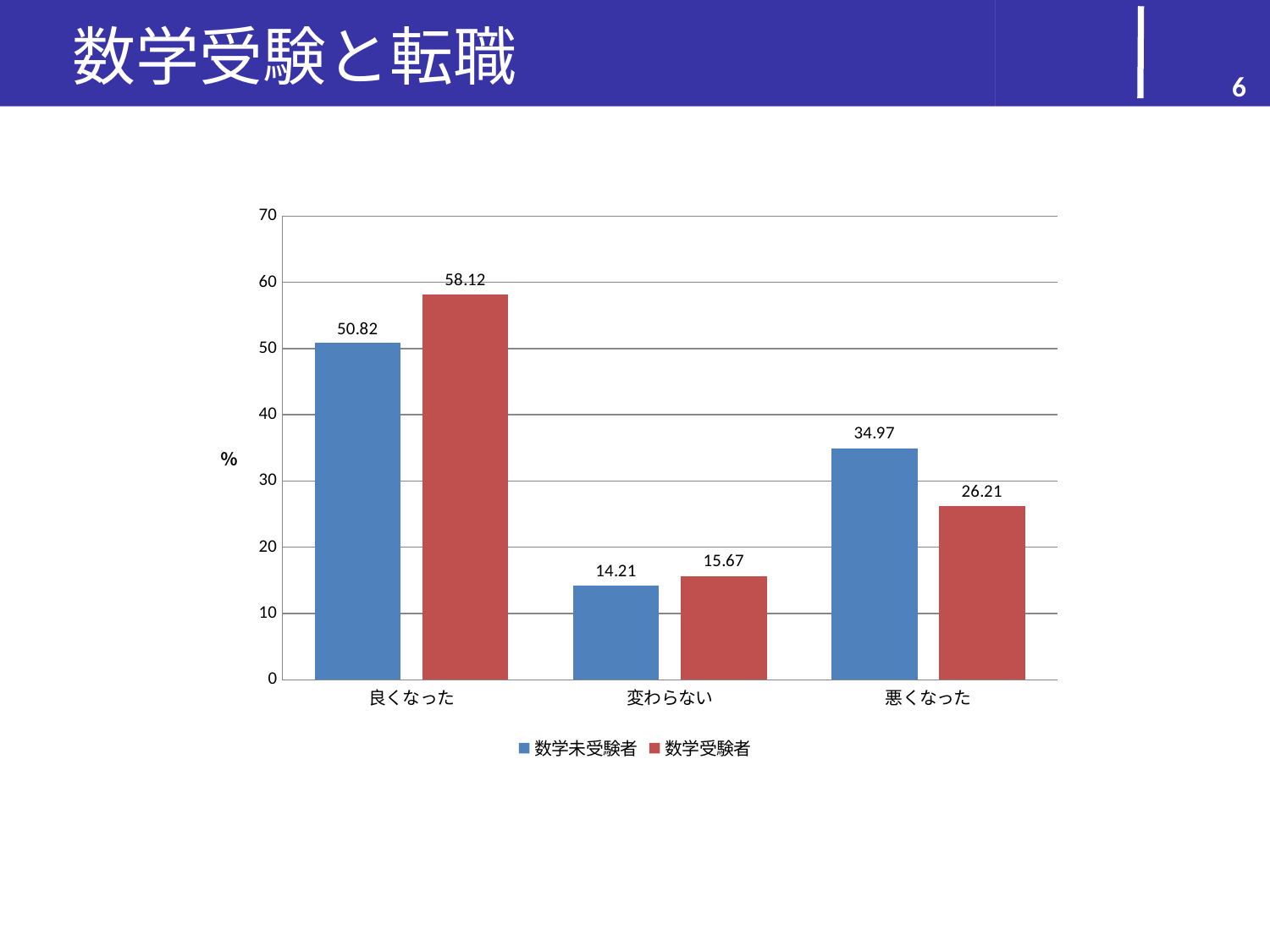
What is the value for 数学受験者 in the 良くなった category? 58.12 How many categories are shown on the x axis? 3 Which category has the lowest value for 数学未受験者? 変わらない What is the value for 数学未受験者 in the 変わらない category? 14.21 How many series does the legend list? 2 What is the difference between 数学受験者 and 数学未受験者 in the 良くなった category? 7.3 What kind of chart is shown on the slide? Bar chart What is the difference between 数学未受験者 and 数学受験者 in the 悪くなった category? 8.76 In the 悪くなった category, which series has the larger value, 数学未受験者 or 数学受験者? 数学未受験者 Which category has the highest value for 数学受験者? 良くなった What is the value for 数学未受験者 in the 悪くなった category? 34.97 What is the label on the vertical axis? %